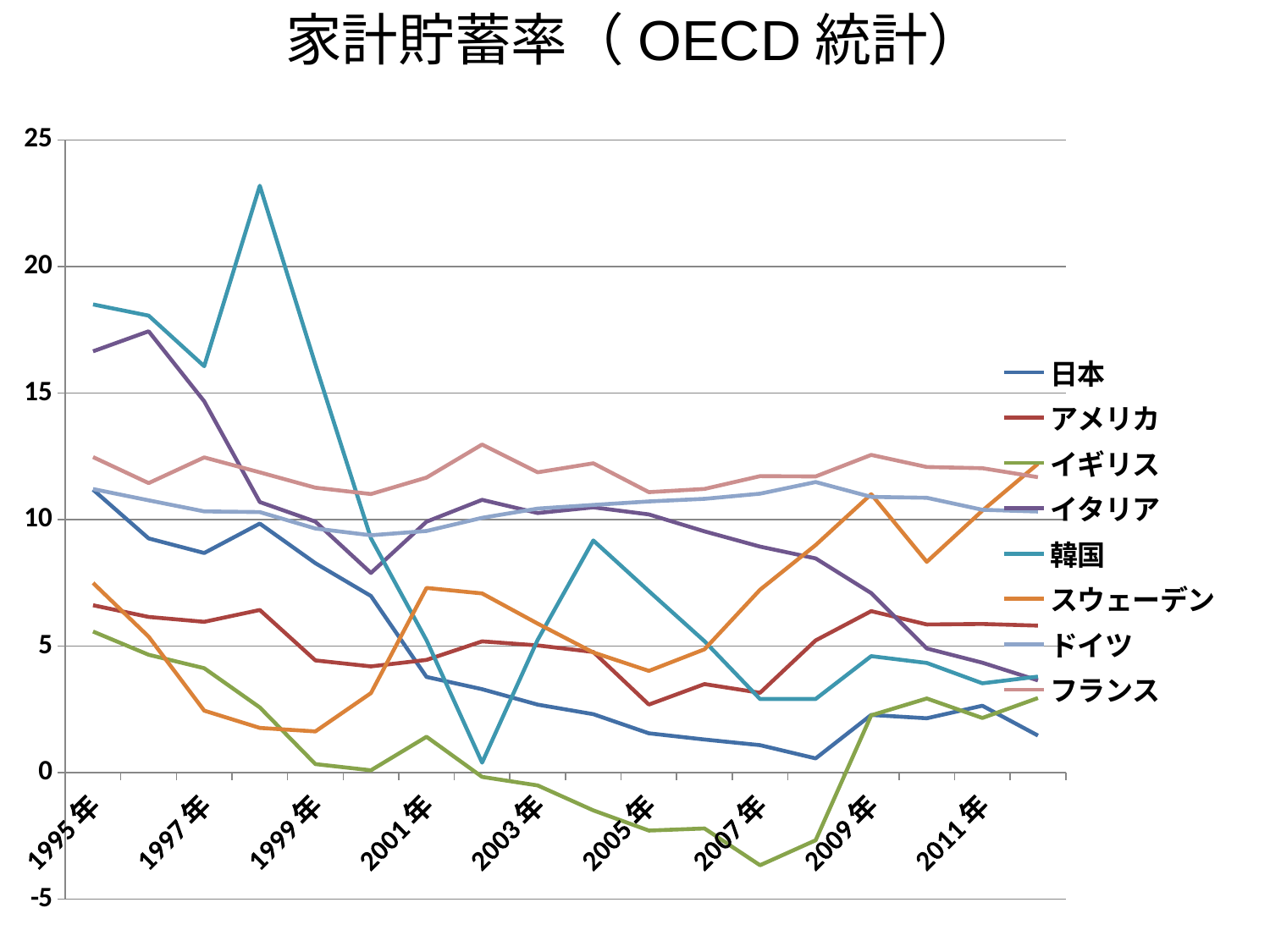
Is the value for 日本 in 2009年 greater or less than 5? less What kind of chart is shown on the slide? line chart Does the value for 日本 rise or fall overall from 1995年 to the end of the chart? fall Is the value for フランス in 2003年 greater or less than 10? greater Which series has the highest value in 2009年? フランス Which series has the lowest value in 1995年? イギリス How many series does the legend list? 8 In 2011年, which is higher, スウェーデン or アメリカ? スウェーデン Is the value for 韓国 in 1995年 greater or less than 15? greater Which series has the lowest value in 2007年? イギリス Which series has the highest value in 1995年? 韓国 What is the title of the chart? 家計貯蓄率（OECD 統計）